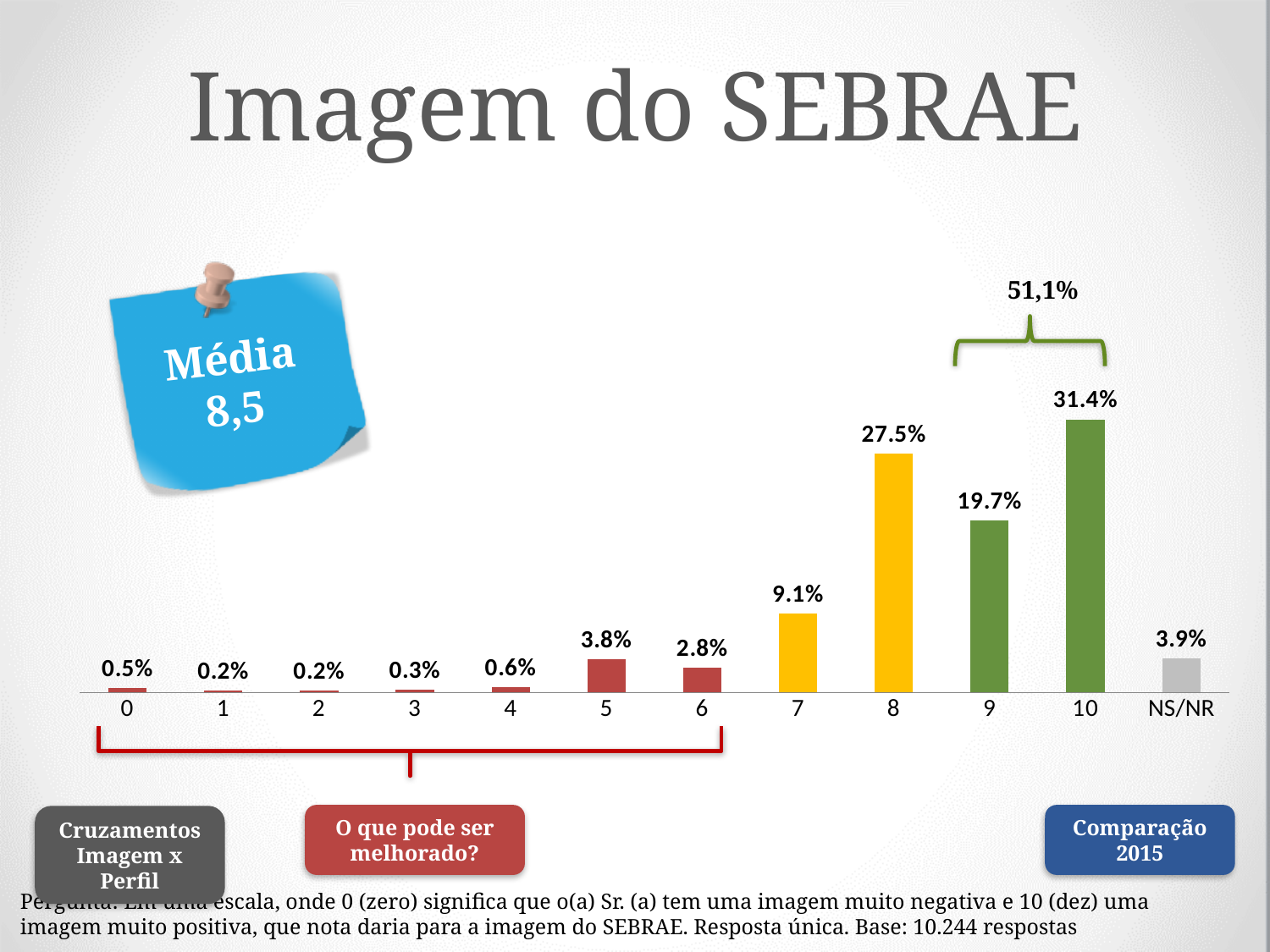
What is the difference between the percentages for scores 10 and 9? 11.7% Which is larger, the value for score 5 or the value for score 6? Score 5 What is the value shown for the score 8 bar? 27.5% What is the value shown for score 7? 9.1% What average (Média) is shown on the sticky note? 8,5 What is the total of the values for scores 5 and 6? 6.6% Which score category has the highest percentage? 10 How many categories are shown on the x axis of the chart? 12 What percentage is shown for the NS/NR category? 3.9% What percentage of respondents gave a score of 10 for the image of SEBRAE? 31.4% What kind of chart is shown on the slide? Bar chart What is the combined percentage shown by the bracket over scores 9 and 10? 51,1%